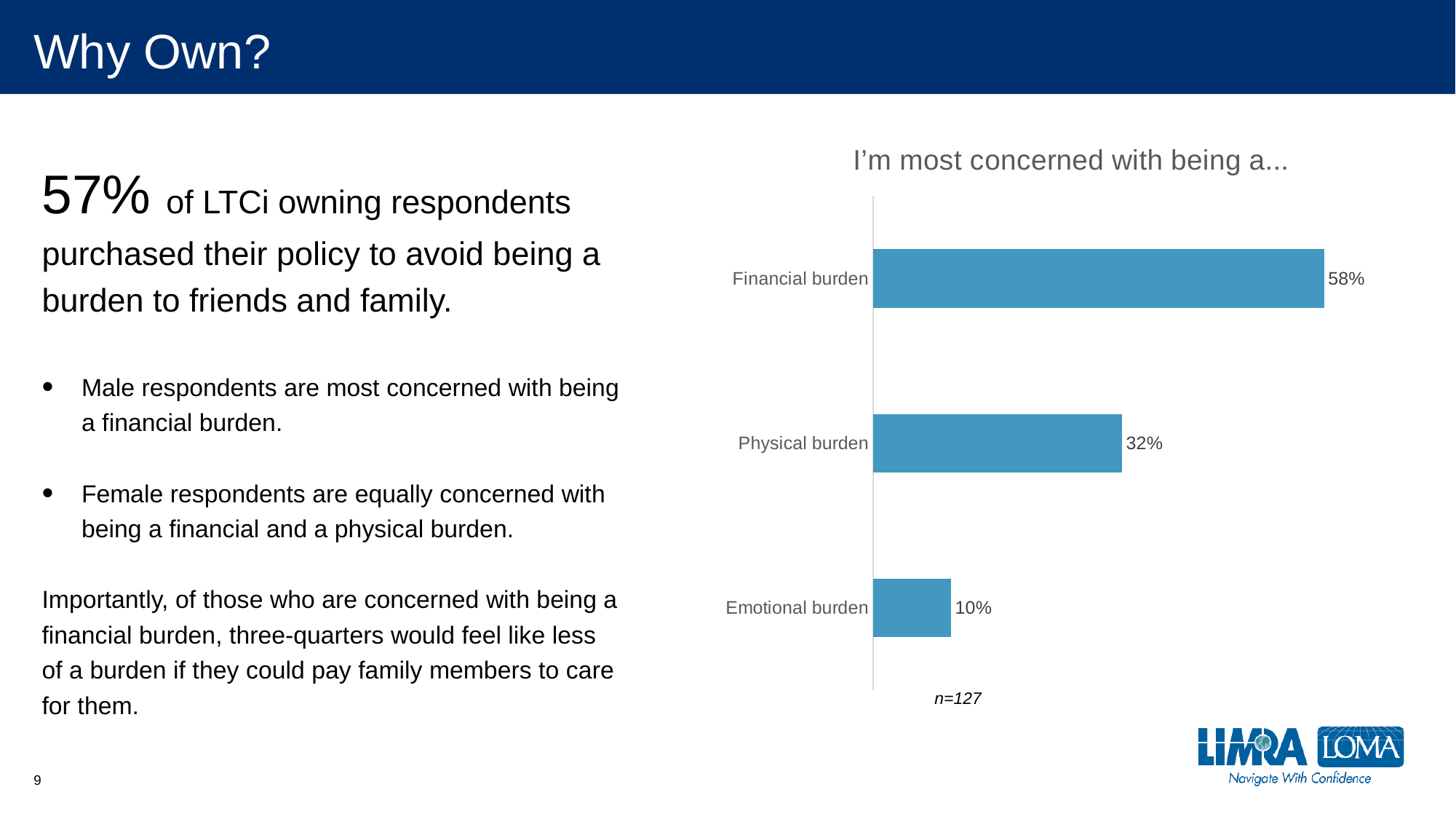
What sample size is noted below the chart? n=127 What is the value for Physical burden? 32% What is the value for Emotional burden? 10% What is the title of the chart? I'm most concerned with being a... Which category has the lowest value? Emotional burden How many categories are shown in the chart? 3 Which is larger, the value for Physical burden or the value for Emotional burden? Physical burden What kind of chart is shown on the slide? Bar chart What is the difference between the values for Physical burden and Emotional burden? 22% Which category has the highest value? Financial burden What is the difference between the values for Financial burden and Physical burden? 26% What is the value for Financial burden? 58%